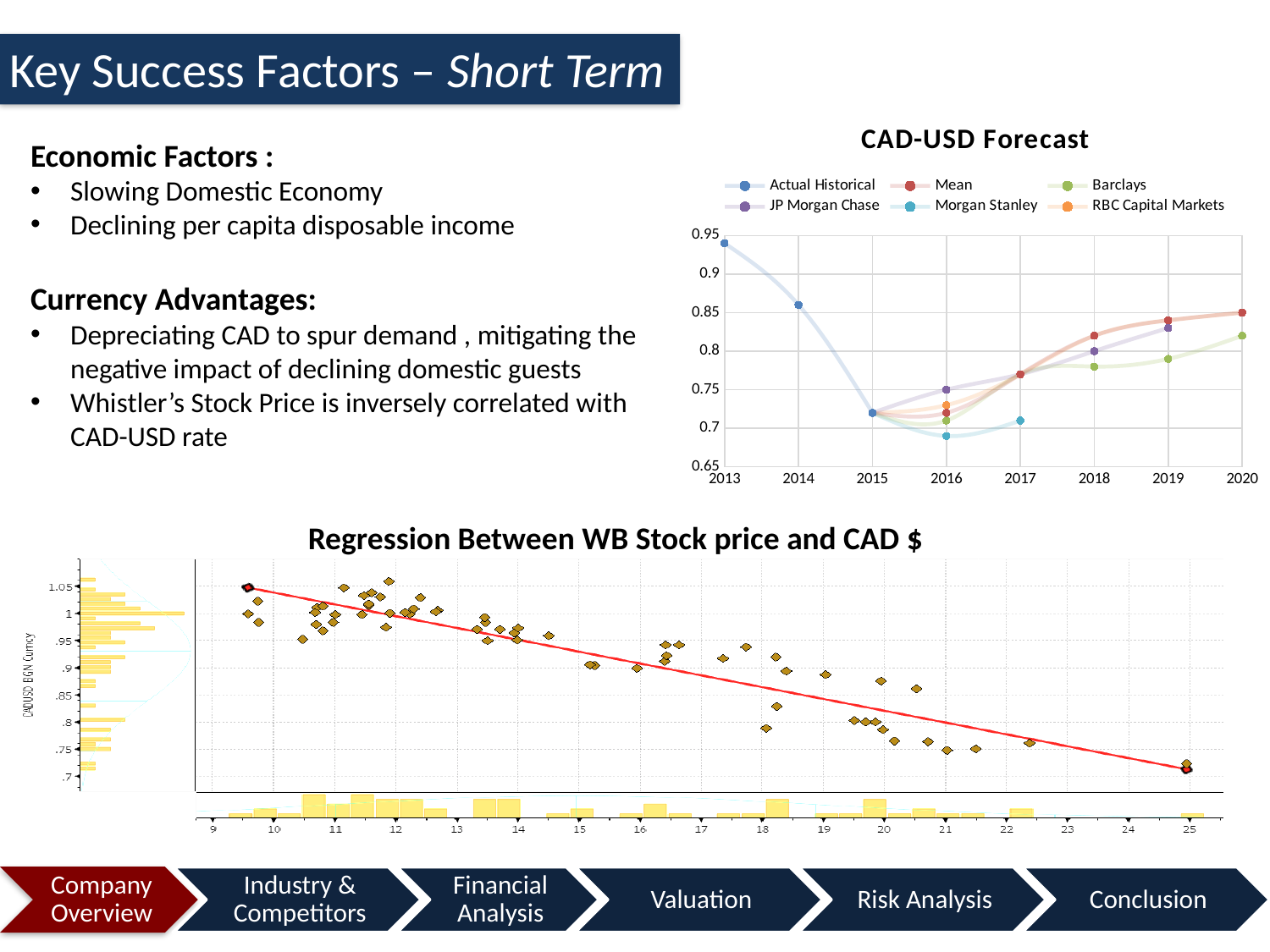
In the CAD-USD Forecast chart, which series has the highest value in 2016? JP Morgan Chase In the Regression Between WB Stock price and CAD $ chart, does the red regression line rise or fall as the stock price increases along the x axis? fall In the CAD-USD Forecast chart, is the Barclays value for 2018 greater or less than 0.8? less How many series does the legend of the CAD-USD Forecast chart list? 6 In the CAD-USD Forecast chart, which series has the lowest value in 2016? Morgan Stanley In the CAD-USD Forecast chart, is the Mean value for 2020 greater or less than 0.8? greater How many years are shown on the x axis of the CAD-USD Forecast chart? 8 In the CAD-USD Forecast chart, is the Actual Historical value for 2013 greater or less than 0.9? greater In the CAD-USD Forecast chart, which is higher in 2019, the Mean or Barclays? Mean In the CAD-USD Forecast chart, does the Actual Historical series rise or fall from 2013 to 2015? fall What kind of chart is the CAD-USD Forecast chart? line chart